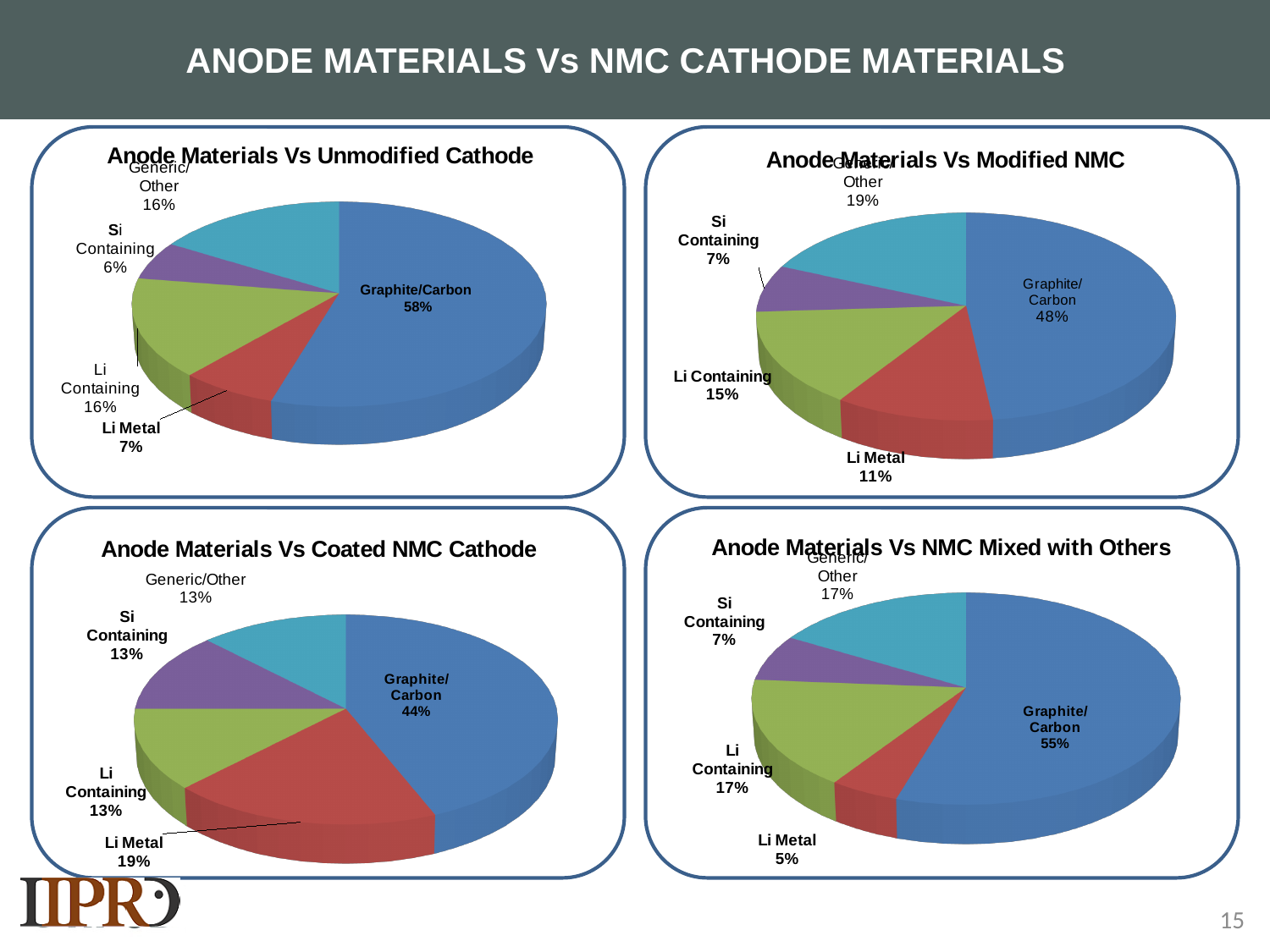
In the 'Anode Materials Vs Coated NMC Cathode' chart, which category has the largest share? Graphite/Carbon What kind of chart is 'Anode Materials Vs Modified NMC'? Pie chart In the 'Anode Materials Vs Modified NMC' chart, what is the share for Li Metal? 11% In the 'Anode Materials Vs Unmodified Cathode' chart, what share does Graphite/Carbon have? 58% In the 'Anode Materials Vs Unmodified Cathode' chart, which category has the smallest share? Si Containing How many charts are shown on the slide? 4 In the 'Anode Materials Vs Modified NMC' chart, what is the difference between the Generic/Other share and the Si Containing share? 12% In the 'Anode Materials Vs Unmodified Cathode' chart, what is the difference between the Graphite/Carbon share and the Li Metal share? 51% In the 'Anode Materials Vs NMC Mixed with Others' chart, which is larger: Li Containing or Si Containing? Li Containing How many categories are shown in the 'Anode Materials Vs Coated NMC Cathode' chart? 5 In the 'Anode Materials Vs Coated NMC Cathode' chart, what is the share for Li Metal? 19%